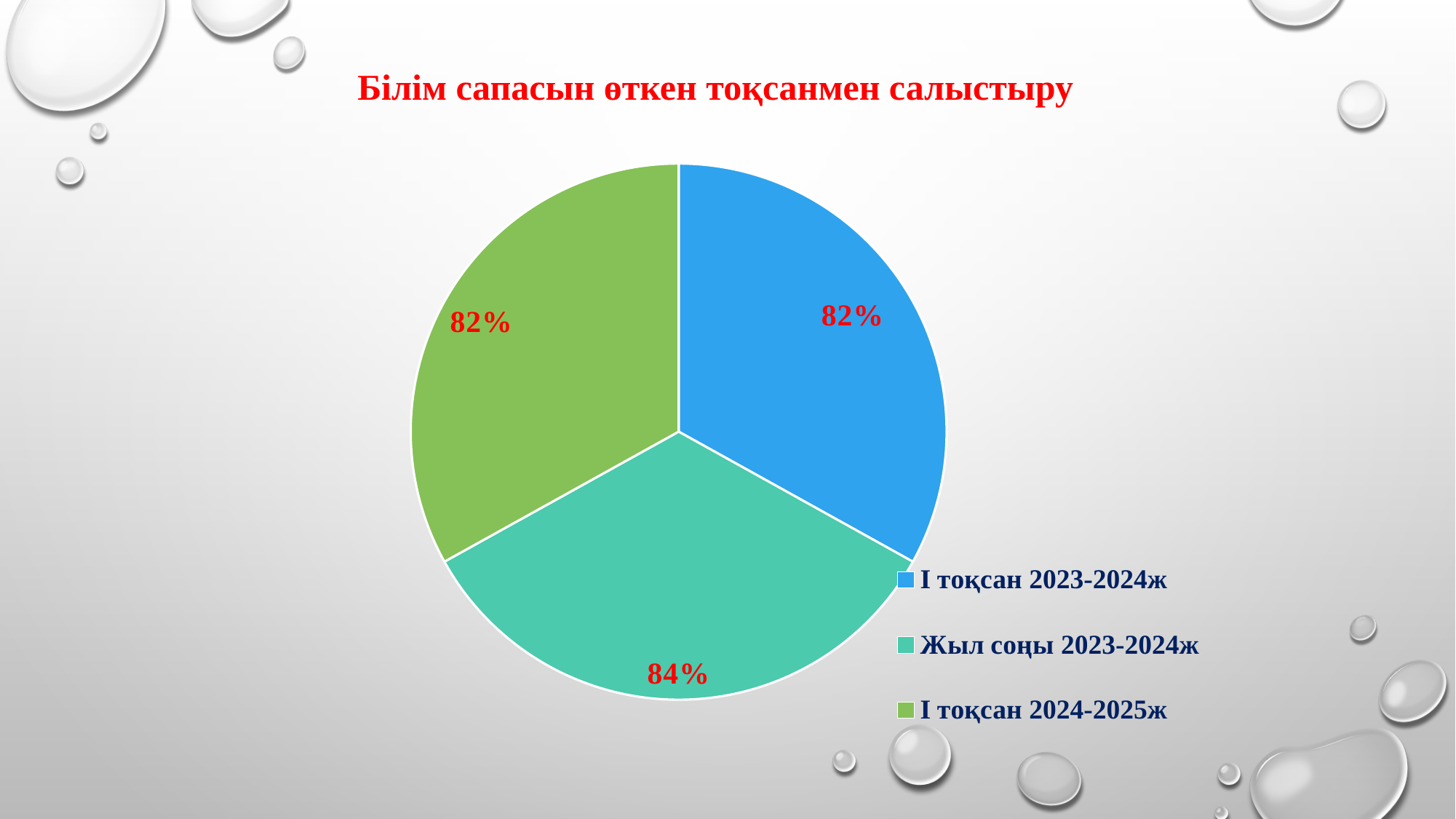
Which has the larger labelled value, I тоқсан 2023-2024ж or Жыл соңы 2023-2024ж? Жыл соңы 2023-2024ж What is the difference between the labelled values for Жыл соңы 2023-2024ж and I тоқсан 2024-2025ж? 2% What is the title of the chart? Білім сапасын өткен тоқсанмен салыстыру How many entries does the legend list? 3 How many slices does the pie chart have? 3 Which category has the highest labelled value? Жыл соңы 2023-2024ж What is the value labelled for the Жыл соңы 2023-2024ж slice? 84% What is the value labelled for the I тоқсан 2023-2024ж slice? 82% What is the value labelled for the I тоқсан 2024-2025ж slice? 82% What kind of chart is shown on the slide? pie chart What colour is the slice for I тоқсан 2024-2025ж? green